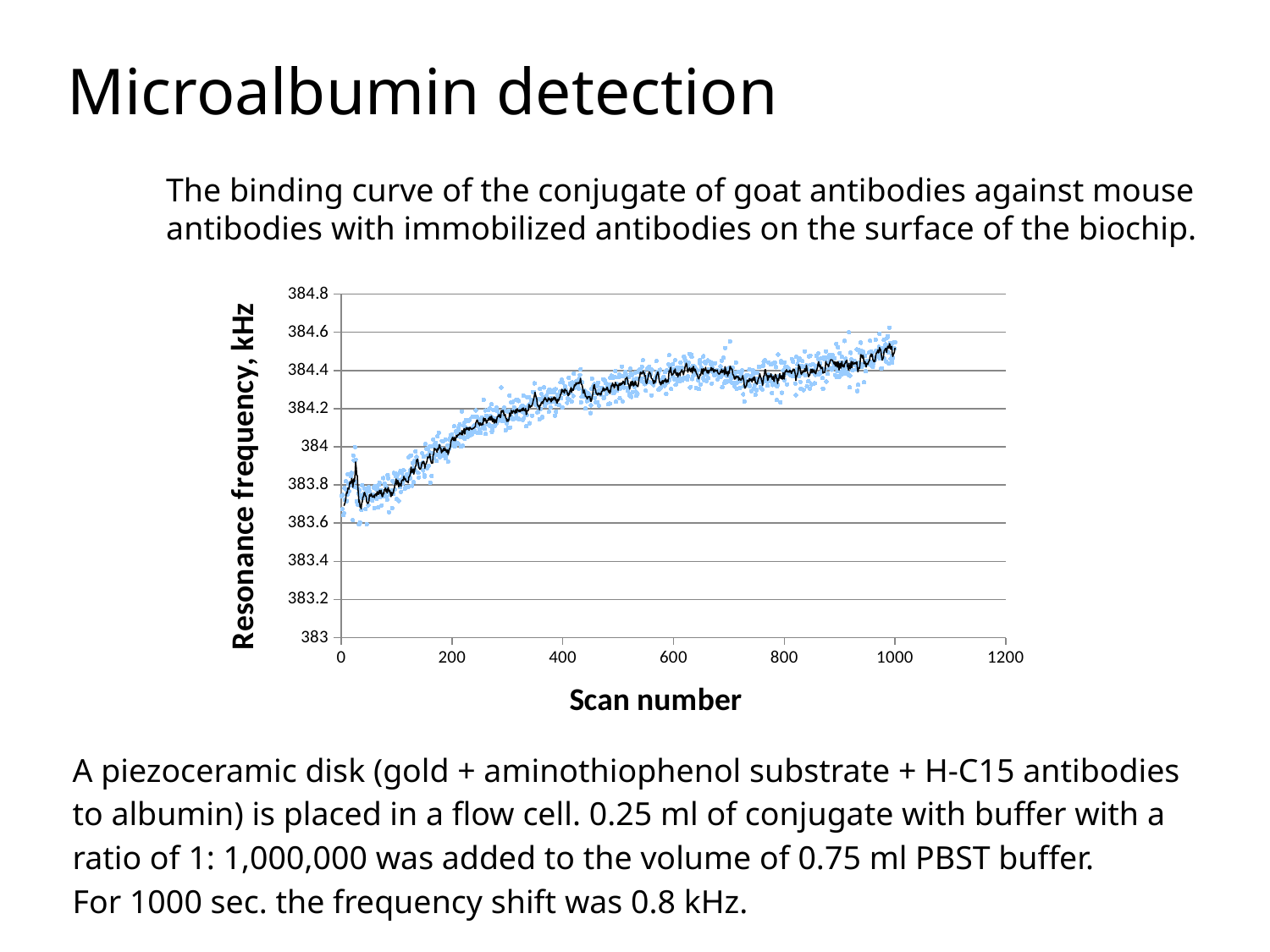
What is the label of the y axis of the chart? Resonance frequency, kHz Is the resonance frequency at scan number 1000 greater or less than 384.4? greater Which has the lower resonance frequency: scan number 300 or scan number 700? Scan number 300 Does the resonance frequency rise or fall as the scan number increases? Rises Is the resonance frequency at scan number 800 greater or less than 384.6? less Is the resonance frequency at scan number 0 greater or less than 384? less What kind of chart is shown on the slide? Scatter chart with a fitted line Which has the higher resonance frequency: scan number 100 or scan number 900? Scan number 900 What is the label of the x axis of the chart? Scan number